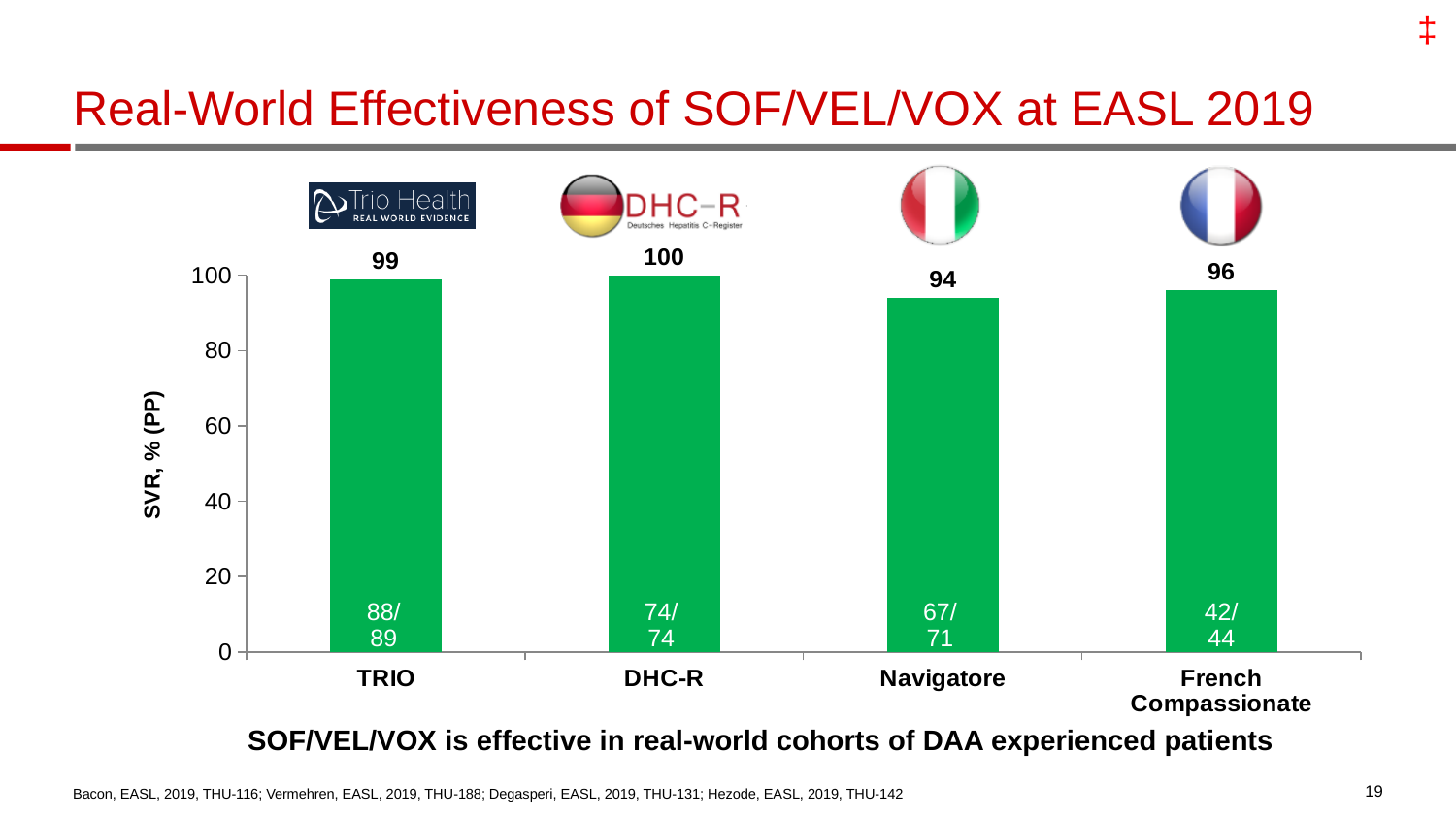
How many cohorts are shown in the chart? 4 Which has a higher SVR value, TRIO or French Compassionate? TRIO What is the difference between the SVR values for DHC-R and Navigatore? 6 What fraction is printed inside the bar for DHC-R? 74/74 What kind of chart is shown on the slide? bar chart What is the SVR value for TRIO? 99 Which cohort has the highest SVR value? DHC-R What is the SVR value for French Compassionate? 96 Is the SVR value for Navigatore greater or less than 80? greater What is the SVR value for Navigatore? 94 Which cohort has the lowest SVR value? Navigatore What is the label of the y axis? SVR, % (PP)